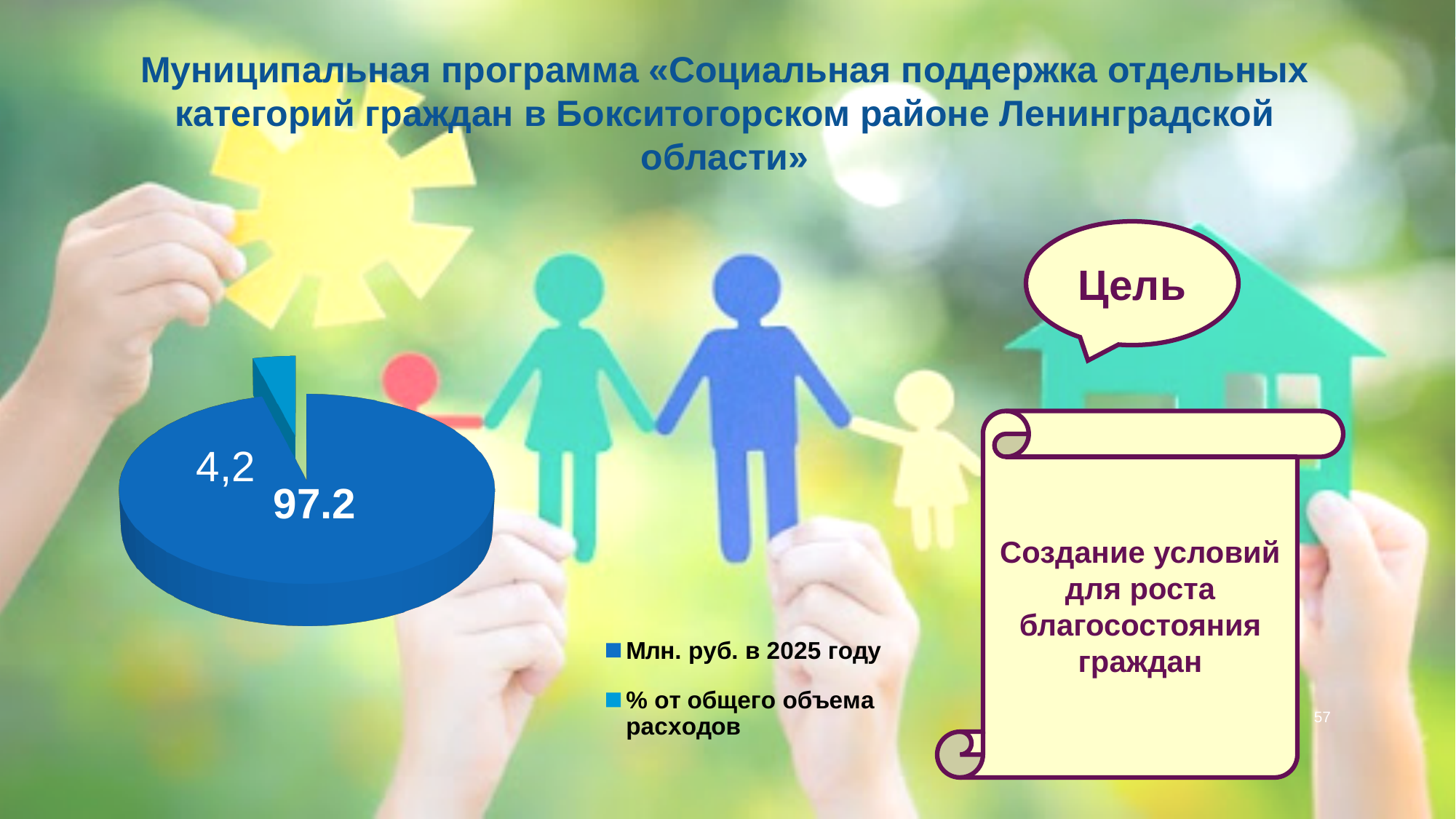
What kind of chart is shown on the slide? Pie chart Which slice of the pie chart is the smallest? % от общего объема расходов How many entries does the legend of the pie chart list? 2 What is the second legend entry of the pie chart? % от общего объема расходов Which is larger in the pie chart: "Млн. руб. в 2025 году" or "% от общего объема расходов"? Млн. руб. в 2025 году What value is shown for "Млн. руб. в 2025 году" in the pie chart? 97.2 What value is shown for "% от общего объема расходов" in the pie chart? 4,2 What is the first legend entry of the pie chart? Млн. руб. в 2025 году How many slices does the pie chart have? 2 Which slice of the pie chart is the largest? Млн. руб. в 2025 году